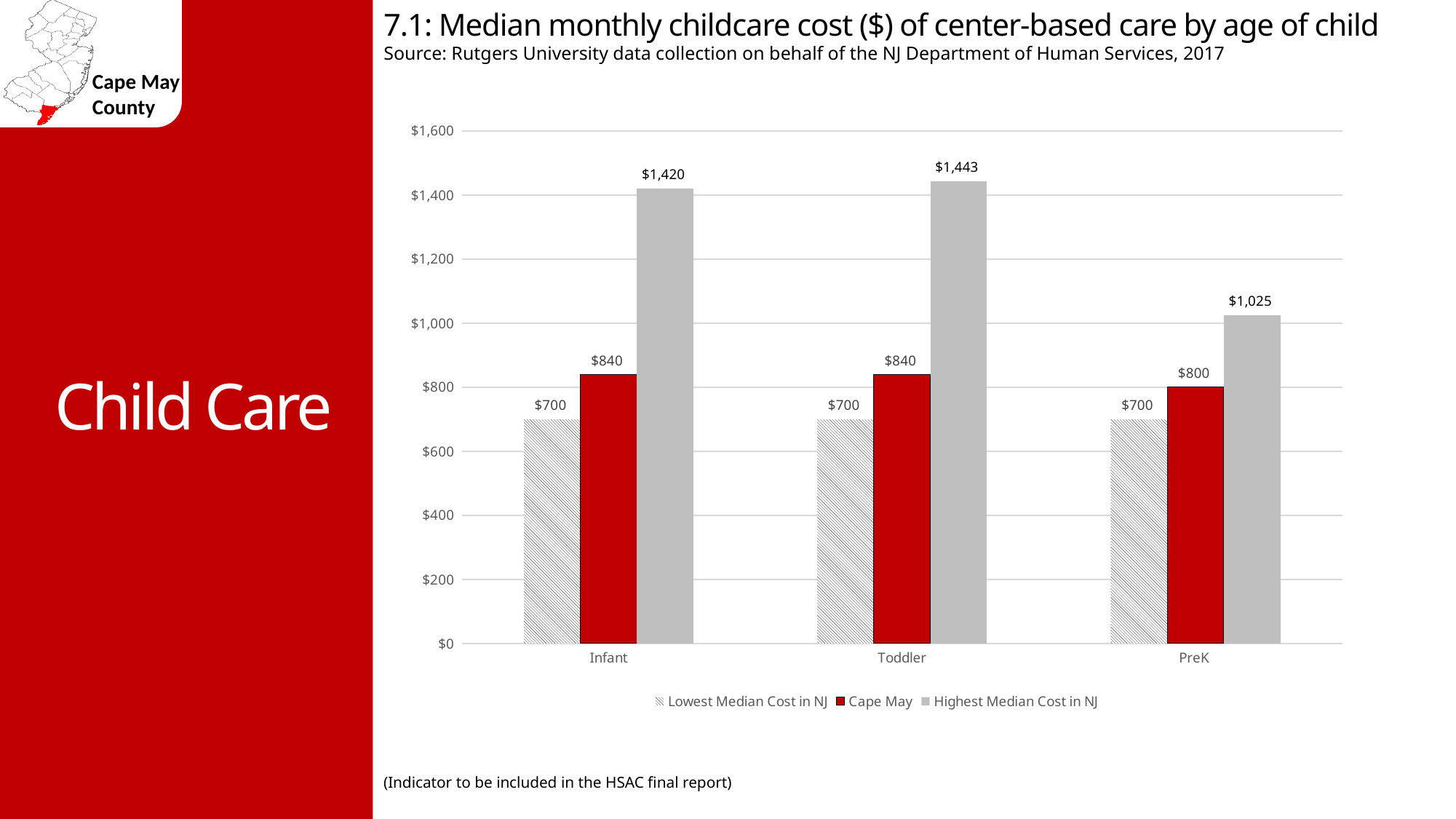
What is the Cape May median monthly childcare cost for Infant care? $840 What is the difference between the Highest Median Cost in NJ and the Cape May cost for Infant care? $580 How many series does the legend list? 3 Which is larger: the Highest Median Cost in NJ for Infant care or for PreK care? Infant What is the difference between the Cape May cost and the Lowest Median Cost in NJ for PreK care? $100 What is the Highest Median Cost in NJ for Toddler care? $1,443 What is the Lowest Median Cost in NJ for PreK care? $700 What kind of chart is shown on the slide? Bar chart What is the Cape May median monthly cost for PreK care? $800 Which age group has the lowest Cape May median monthly cost? PreK Which age group has the highest value for the Highest Median Cost in NJ series? Toddler How many age groups are shown on the x axis? 3